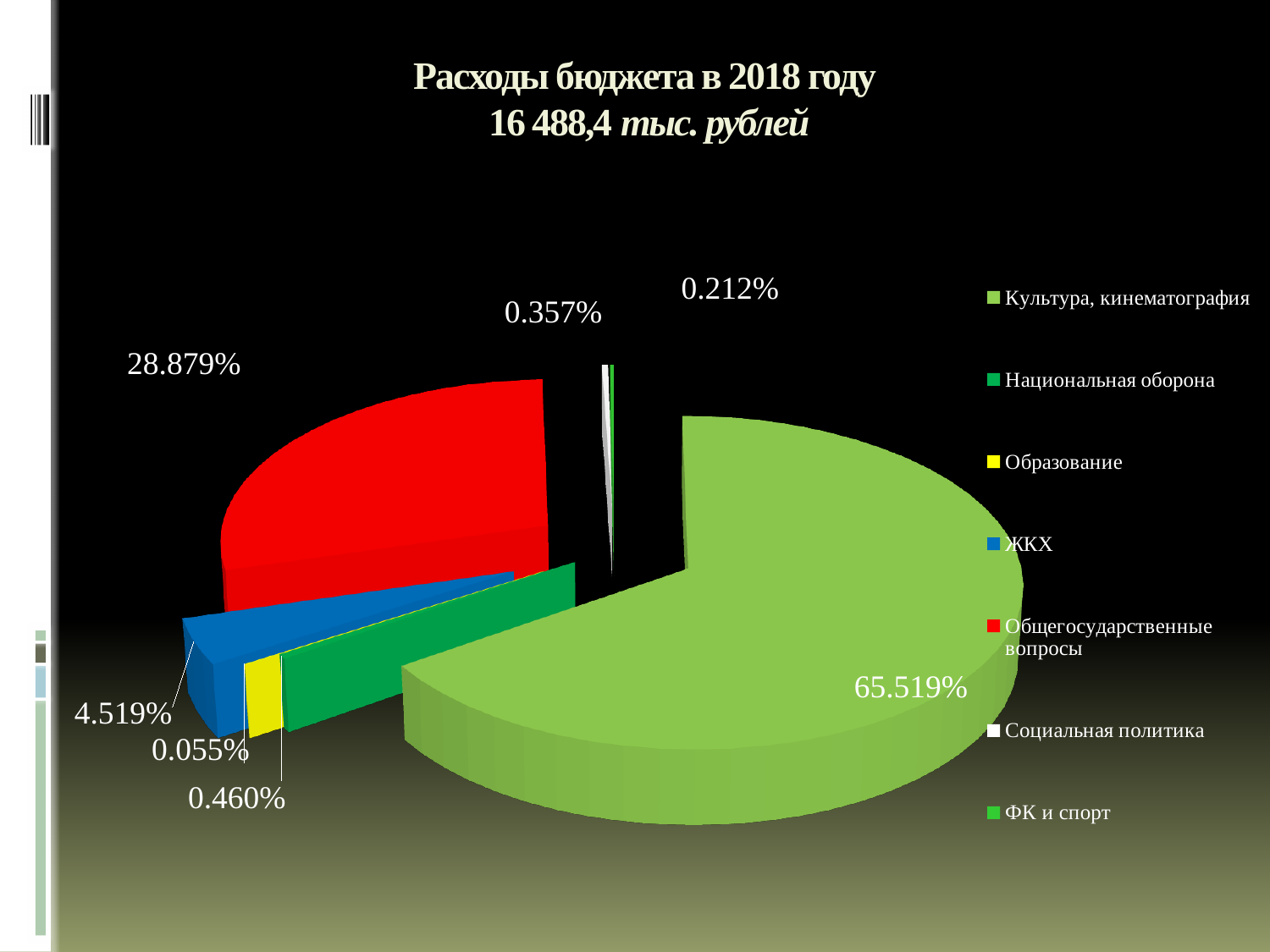
Which category has the smallest slice of the pie? Образование Which category has the largest slice of the pie? Культура, кинематография What is the difference between the shares of Культура, кинематография and Общегосударственные вопросы? 36.640% How many categories does the legend of the pie chart list? 7 What share of the pie does ЖКХ have? 4.519% Which has a larger share, ЖКХ or Национальная оборона? ЖКХ What share of the pie does Национальная оборона have? 0.460% What share of the pie does Общегосударственные вопросы have? 28.879% What is the title of the chart on the slide? Расходы бюджета в 2018 году 16 488,4 тыс. рублей What share of the pie does Образование have? 0.055% What share of the pie does Культура, кинематография have? 65.519% What kind of chart is shown on the slide? pie chart